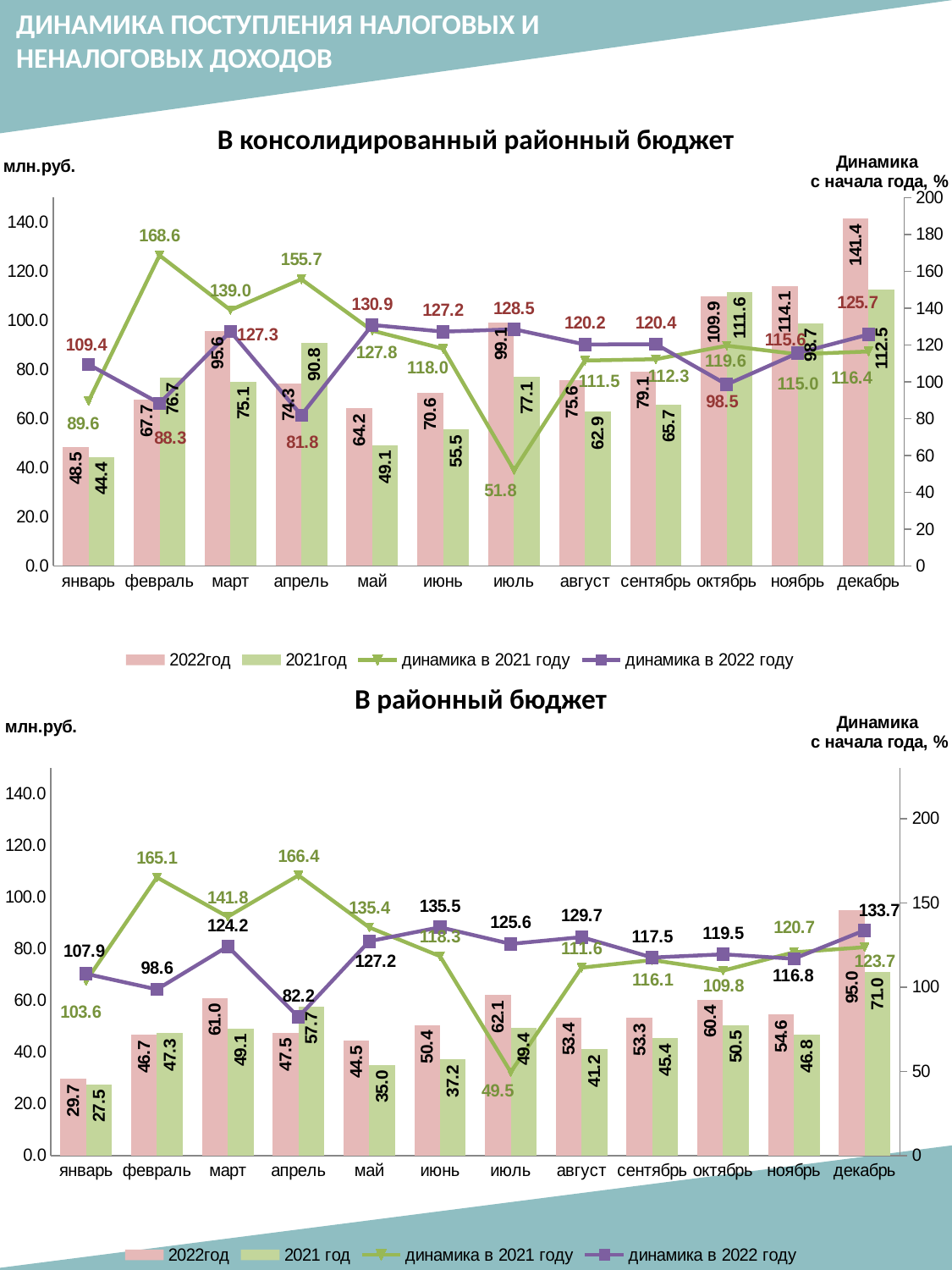
How many series does the legend of the chart 'В районный бюджет' list? 4 In the chart 'В консолидированный районный бюджет', what is the value of the 2022год bar for декабрь? 141.4 In the chart 'В консолидированный районный бюджет', what is the difference between the 2022год and 2021год bars for ноябрь? 15.4 In the chart 'В районный бюджет', what is the difference between the 2022год and 2021год bars for март? 11.9 In the chart 'В районный бюджет', what is the value of the 'динамика в 2022 году' line for июнь? 135.5 In the chart 'В консолидированный районный бюджет', which month has the lowest value on the 'динамика в 2021 году' line? июль In the chart 'В районный бюджет', which month has the lowest 2021 год bar? январь In the chart 'В консолидированный районный бюджет', which is larger for февраль: the 2022год bar or the 2021год bar? 2021год How many months are shown on the x axis of the chart 'В консолидированный районный бюджет'? 12 In the chart 'В консолидированный районный бюджет', which month has the highest value on the 'динамика в 2021 году' line? февраль In the chart 'В районный бюджет', what is the value of the 2022год bar for декабрь? 95.0 In the chart 'В консолидированный районный бюджет', what is the value of the 2021год bar for апрель? 90.8